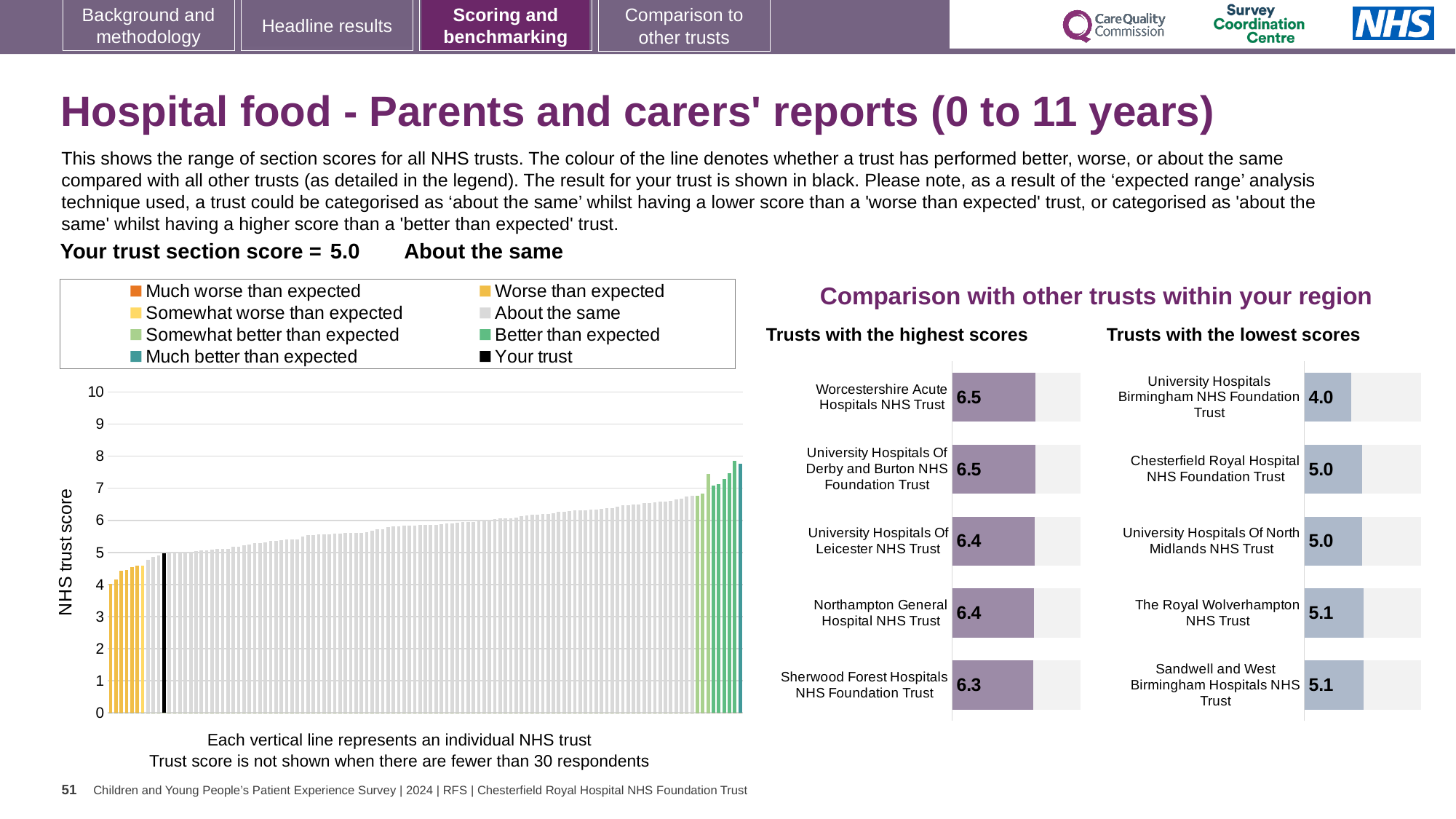
In the 'Trusts with the lowest scores' chart, what is the score for The Royal Wolverhampton NHS Trust? 5.1 In the 'Trusts with the highest scores' chart, what is the score for Sherwood Forest Hospitals NHS Foundation Trust? 6.3 In the 'Trusts with the lowest scores' chart, what is the score for University Hospitals Birmingham NHS Foundation Trust? 4.0 In the main chart on the left showing all NHS trusts, is the value for the black 'Your trust' bar greater or less than 6? less In the 'Trusts with the highest scores' chart, what is the score for Worcestershire Acute Hospitals NHS Trust? 6.5 In the 'Trusts with the highest scores' chart, which has the larger score: University Hospitals Of Leicester NHS Trust or Sherwood Forest Hospitals NHS Foundation Trust? University Hospitals Of Leicester NHS Trust In the 'Trusts with the lowest scores' chart, what is the difference between the scores of Sandwell and West Birmingham Hospitals NHS Trust and University Hospitals Birmingham NHS Foundation Trust? 1.1 In the 'Trusts with the highest scores' chart, which trust has the lowest score? Sherwood Forest Hospitals NHS Foundation Trust In the 'Trusts with the lowest scores' chart, which trust has the lowest score? University Hospitals Birmingham NHS Foundation Trust In the main chart on the left showing all NHS trusts, do the bar values rise or fall from left to right? rise How many entries does the legend of the main chart on the left list? 8 How many trusts are listed in the 'Trusts with the lowest scores' chart? 5